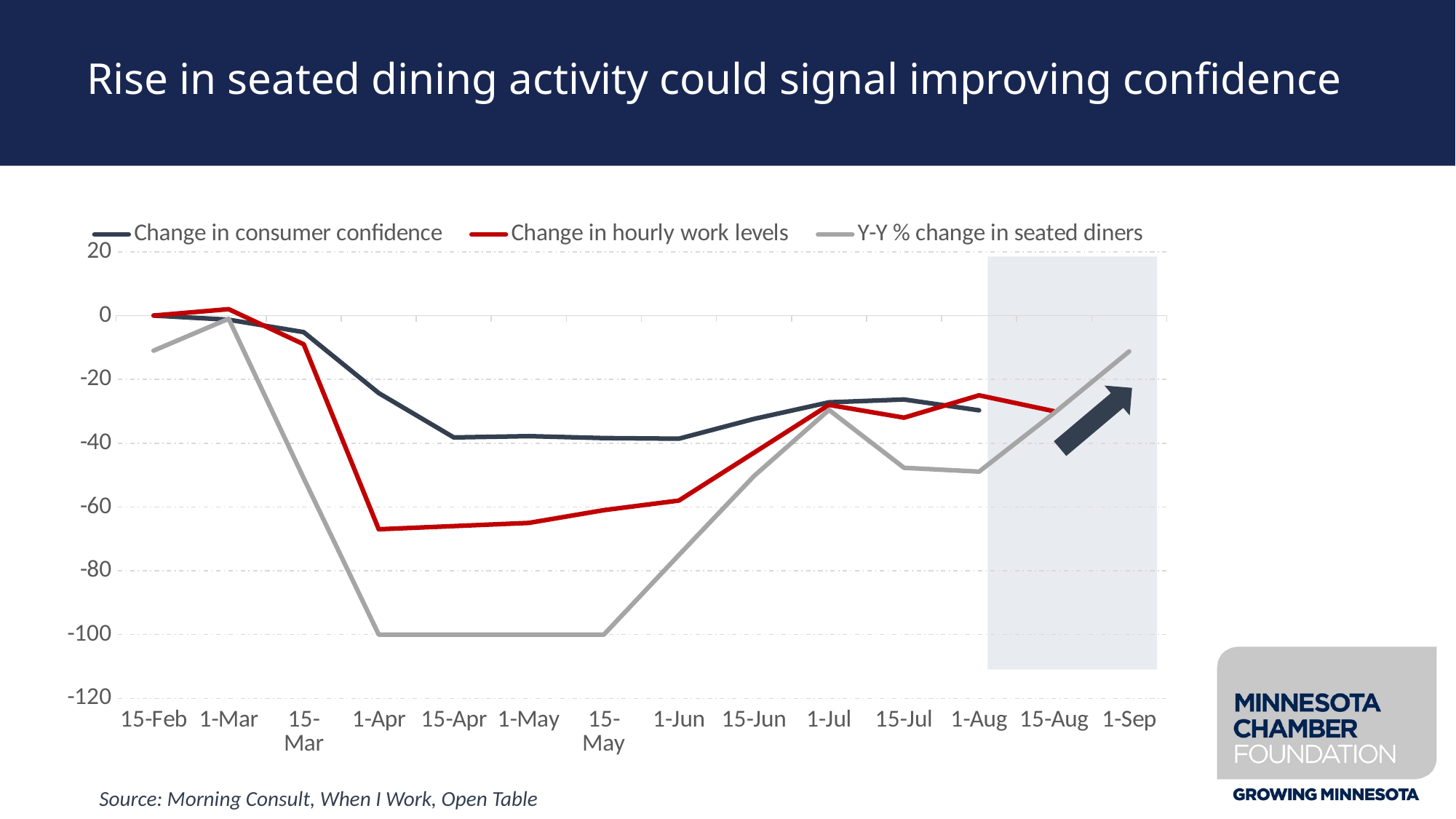
Is the value for Y-Y % change in seated diners on 1-Sep greater or less than -20? greater Does the Y-Y % change in seated diners line rise or fall from 1-Aug to 1-Sep? Rise Is the value for Change in hourly work levels on 1-Apr greater or less than -60? less What is the lowest value reached by the Y-Y % change in seated diners line? -100 Which series reaches the lowest value on the chart? Y-Y % change in seated diners What type of chart is shown on the slide? Line chart How many series does the legend list? 3 What is the title of the slide? Rise in seated dining activity could signal improving confidence How many dates are labelled along the x axis? 14 What is the Y-Y % change in seated diners on 1-Apr? -100 Is the value for Change in consumer confidence on 15-Apr greater or less than -20? less On 1-Apr, which is higher: Change in consumer confidence or Change in hourly work levels? Change in consumer confidence